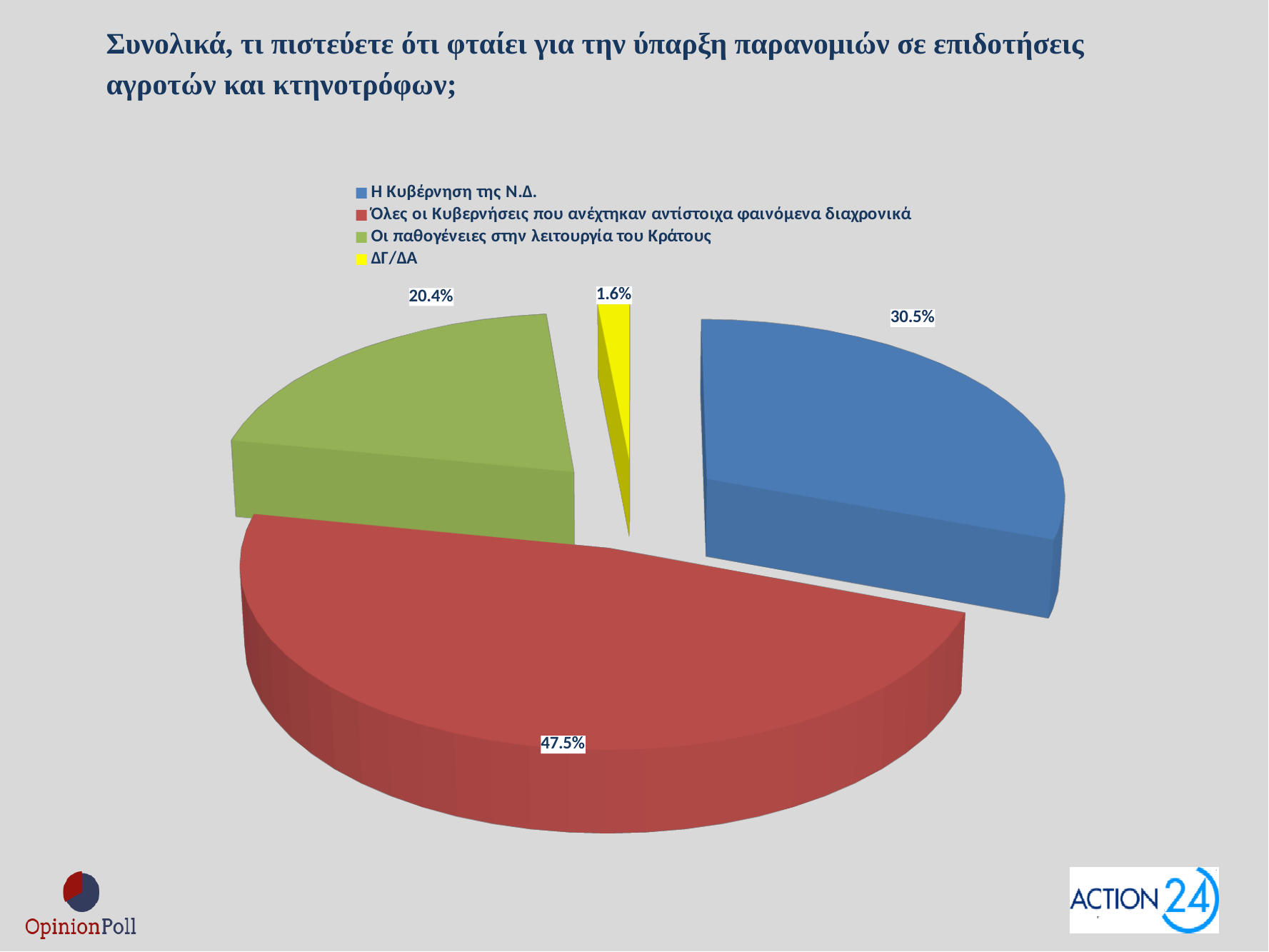
What colour is the slice for 'Οι παθογένειες στην λειτουργία του Κράτους'? Green Which category has the largest share of the pie? Όλες οι Κυβερνήσεις που ανέχτηκαν αντίστοιχα φαινόμενα διαχρονικά Which is larger: the share for 'Η Κυβέρνηση της Ν.Δ.' or the share for 'Οι παθογένειες στην λειτουργία του Κράτους'? Η Κυβέρνηση της Ν.Δ. What is the difference in percentage points between 'Όλες οι Κυβερνήσεις που ανέχτηκαν αντίστοιχα φαινόμενα διαχρονικά' and 'Η Κυβέρνηση της Ν.Δ.'? 17 percentage points What percentage is shown for 'ΔΓ/ΔΑ'? 1.6% What percentage is shown for 'Όλες οι Κυβερνήσεις που ανέχτηκαν αντίστοιχα φαινόμενα διαχρονικά'? 47.5% How many categories does the pie chart show? 4 What percentage of respondents blame 'Η Κυβέρνηση της Ν.Δ.'? 30.5% What percentage is shown for 'Οι παθογένειες στην λειτουργία του Κράτους'? 20.4% What colour is the slice for 'ΔΓ/ΔΑ'? Yellow What type of chart is shown on the slide? Pie chart Which category has the smallest share of the pie? ΔΓ/ΔΑ